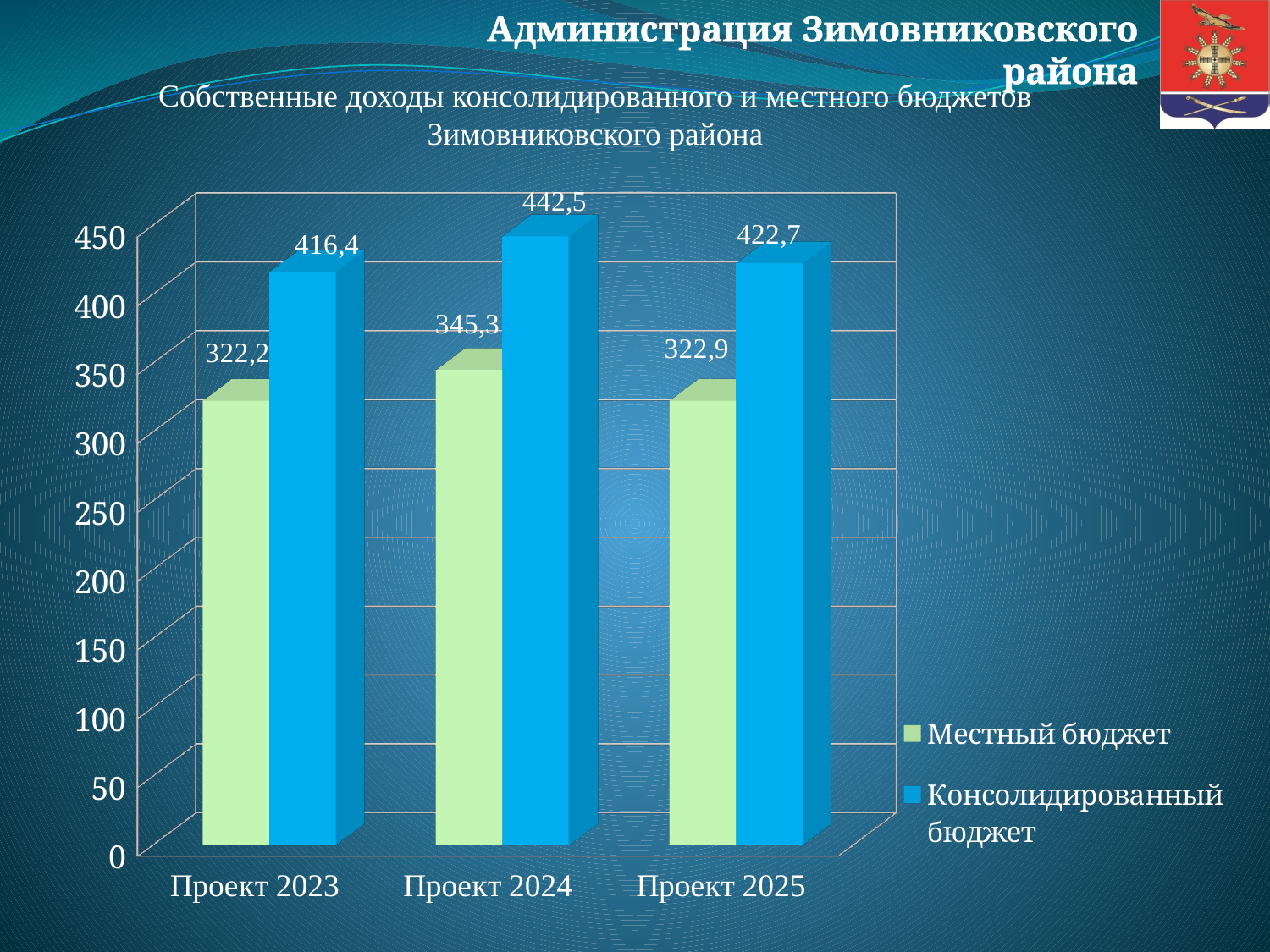
What is the difference between Консолидированный бюджет and Местный бюджет for Проект 2024? 97,2 What is the value of Консолидированный бюджет for Проект 2025? 422,7 Is the value of Консолидированный бюджет for Проект 2025 greater or less than 400? greater In which category is Консолидированный бюджет highest? Проект 2024 What is the value of Местный бюджет for Проект 2024? 345,3 How many categories are shown on the x axis? 3 What kind of chart is shown on the slide? bar chart How many series does the legend list? 2 Which is larger: Местный бюджет for Проект 2024 or Местный бюджет for Проект 2025? Проект 2024 What is the value of Консолидированный бюджет for Проект 2023? 416,4 What is the difference between Консолидированный бюджет for Проект 2024 and Проект 2023? 26,1